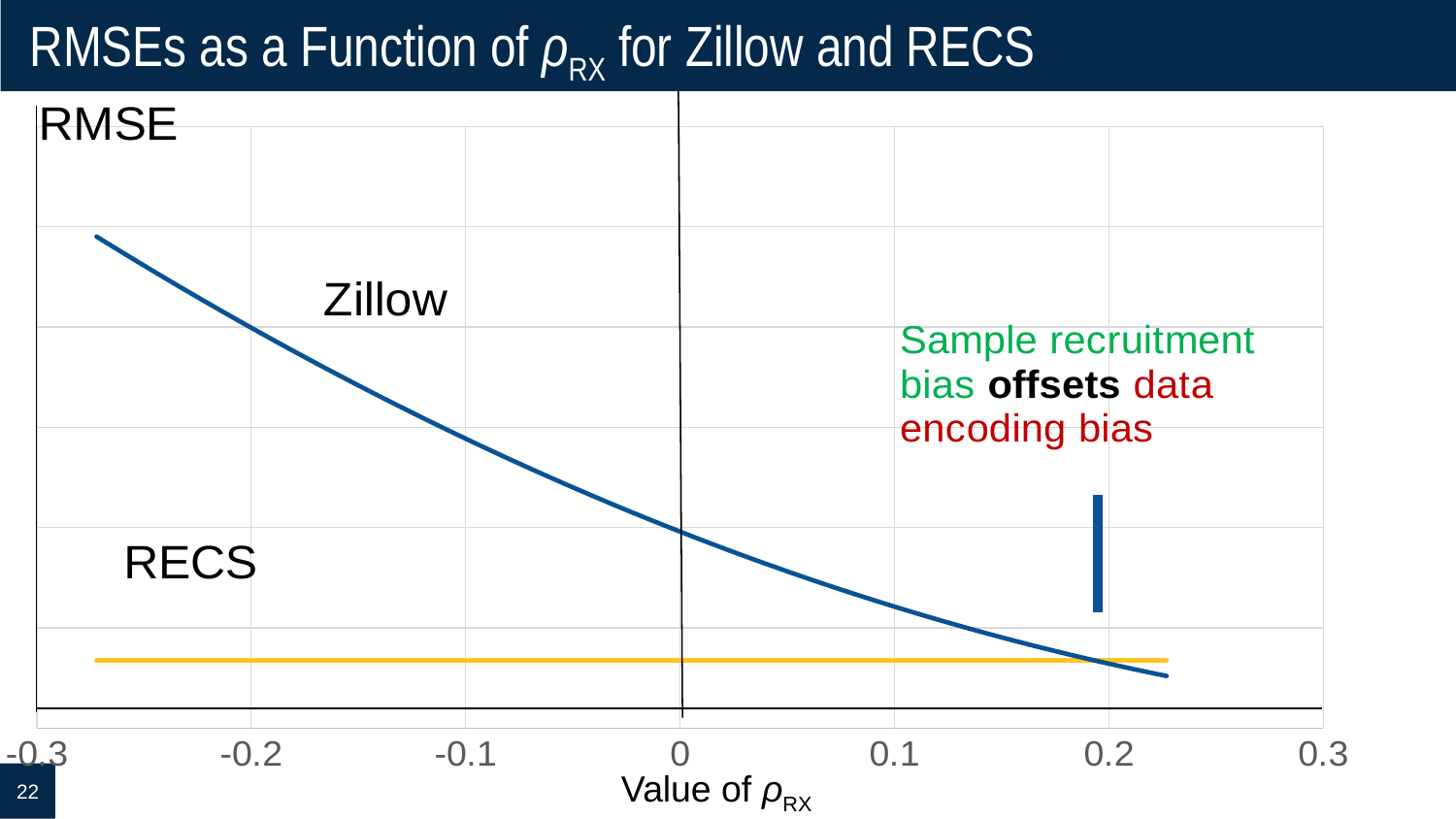
For the Zillow series, is the RMSE at ρRX = -0.2 larger or smaller than at ρRX = 0.1? Larger Does the Zillow RMSE rise or fall as the value of ρRX increases? Fall Does the RECS RMSE rise, fall, or stay flat as the value of ρRX increases? Stay flat At ρRX = -0.2, which series has the higher RMSE, Zillow or RECS? Zillow At ρRX = 0, which series has the higher RMSE, Zillow or RECS? Zillow What kind of chart is shown on the slide? Line chart How many series are plotted on the chart? 2 How many tick labels are shown on the x axis? 7 What is the lowest tick value shown on the x axis? -0.3 What is the highest tick value shown on the x axis? 0.3 What is the label on the x axis? Value of ρRX Which two series are labelled on the chart? Zillow and RECS